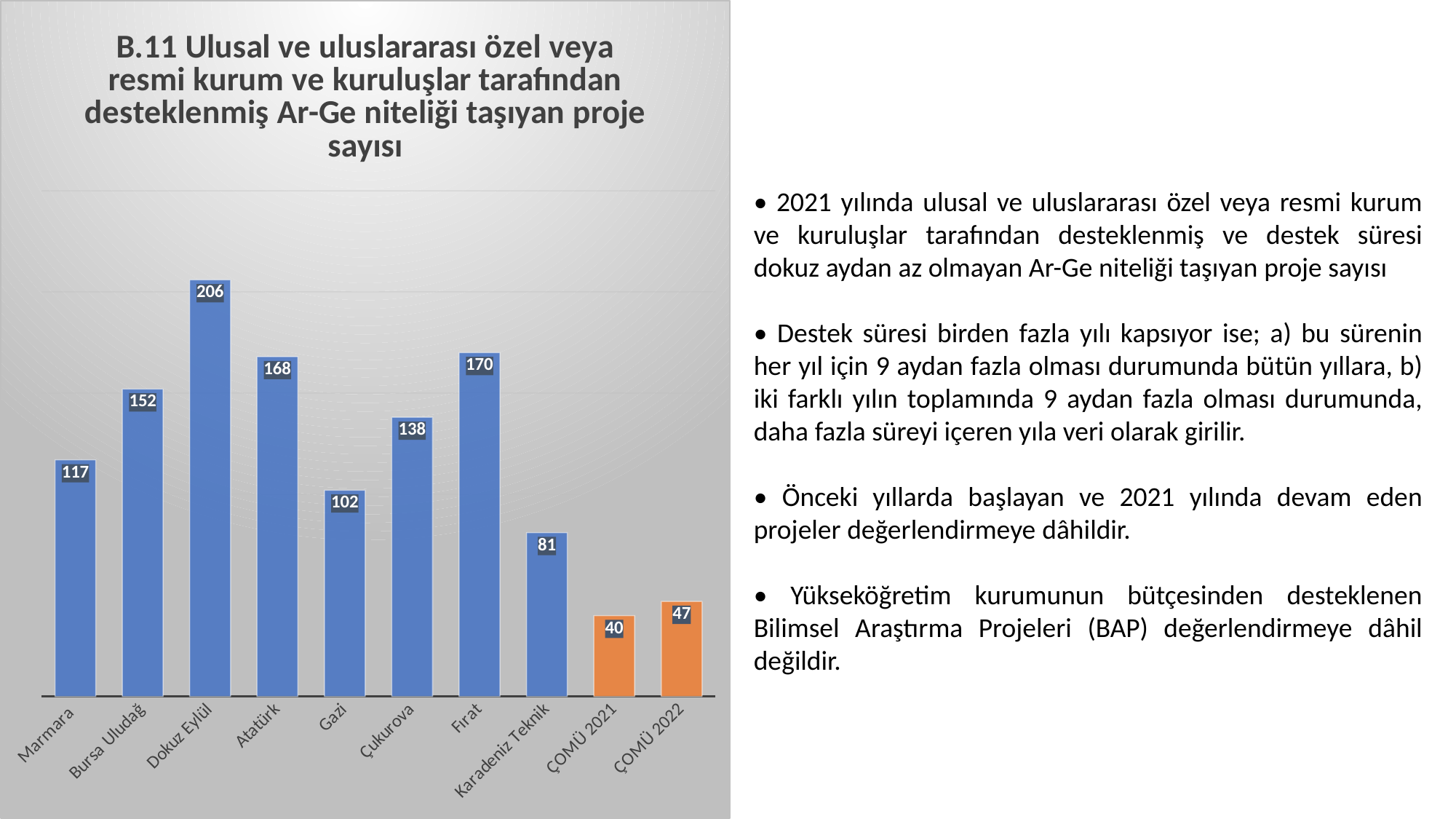
How many categories are shown on the x axis? 10 What is the value for ÇOMÜ 2022? 47 Which category has the highest value? Dokuz Eylül What is the difference between the values for ÇOMÜ 2022 and ÇOMÜ 2021? 7 Which is larger, the value for Atatürk or the value for Bursa Uludağ? Atatürk What kind of chart is shown on the slide? bar chart What is the value for Dokuz Eylül? 206 What is the difference between the values for Dokuz Eylül and Fırat? 36 Which is larger, the value for Gazi or the value for Marmara? Marmara Which bars are coloured orange rather than blue? ÇOMÜ 2021 and ÇOMÜ 2022 Which category has the lowest value? ÇOMÜ 2021 What is the value for Karadeniz Teknik? 81